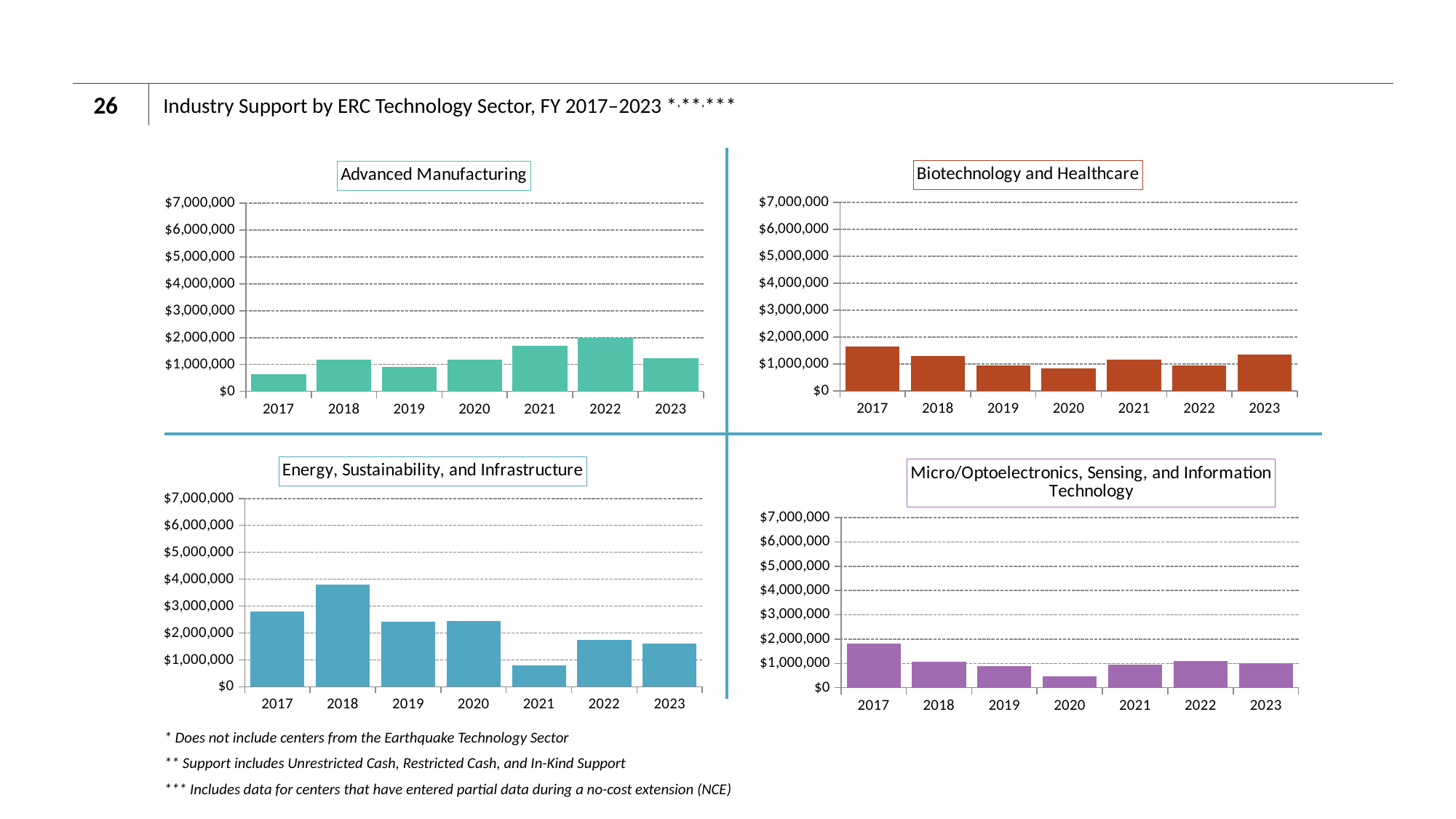
In the Advanced Manufacturing chart, which year has the lowest industry support? 2017 In the Advanced Manufacturing chart, which year has the highest industry support? 2022 In the Biotechnology and Healthcare chart, which year has the highest industry support? 2017 How many years are shown on the x axis of the Biotechnology and Healthcare chart? 7 In the Energy, Sustainability, and Infrastructure chart, which year has the lowest industry support? 2021 In the Micro/Optoelectronics, Sensing, and Information Technology chart, which is larger, the value for 2017 or the value for 2018? 2017 In the Advanced Manufacturing chart, is the value for 2017 greater or less than $1,000,000? less In the Energy, Sustainability, and Infrastructure chart, is the value for 2018 greater or less than $3,000,000? greater In the Micro/Optoelectronics, Sensing, and Information Technology chart, which year has the lowest industry support? 2020 In the Biotechnology and Healthcare chart, is the value for 2017 greater or less than $1,000,000? greater What type of chart is the Energy, Sustainability, and Infrastructure chart? bar chart In the Energy, Sustainability, and Infrastructure chart, which year has the highest industry support? 2018